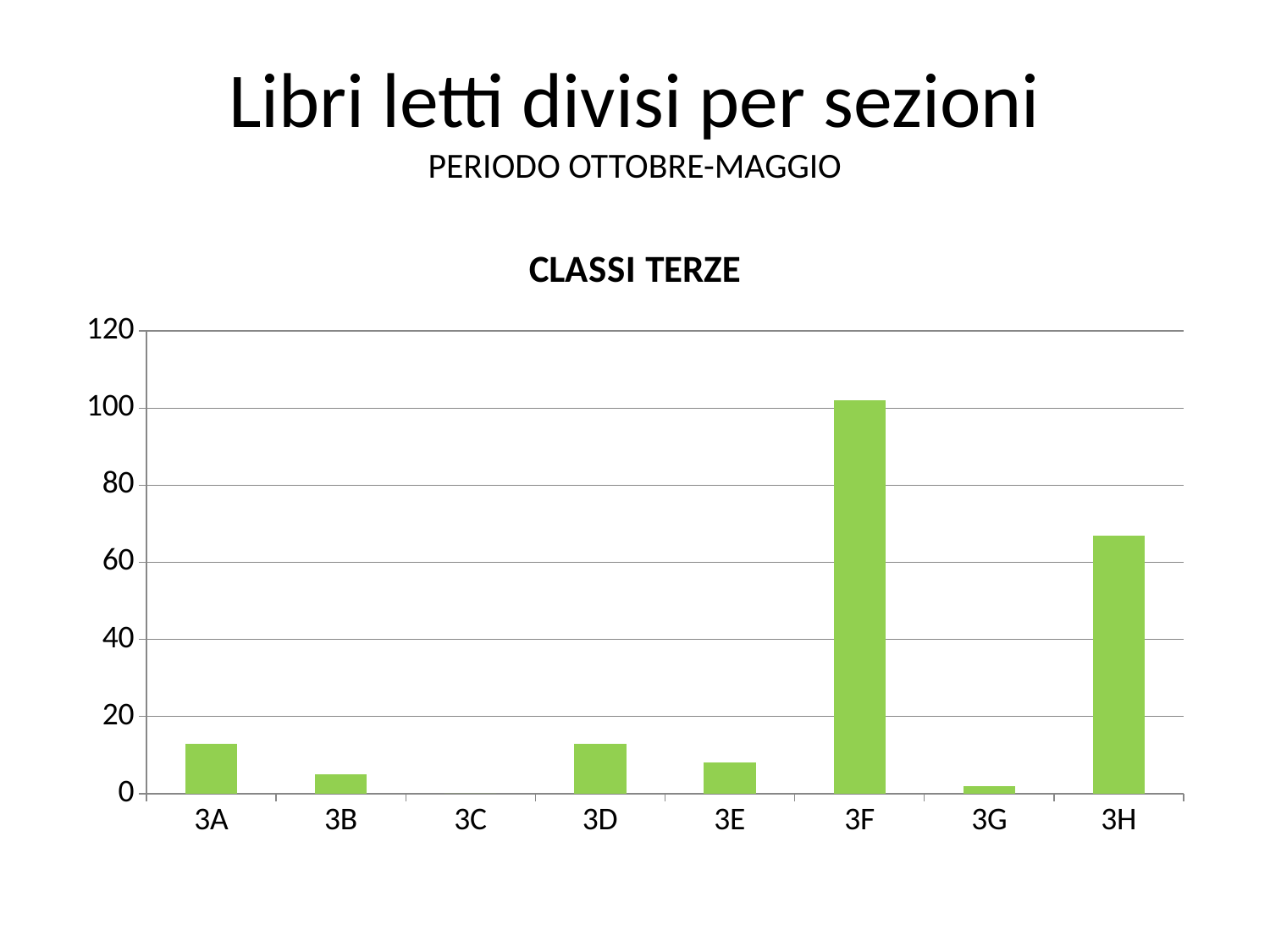
Which class has the lowest number of books read? 3C How many classes (categories) are shown on the x axis of the chart? 8 What kind of chart is shown on the slide? bar chart Which is larger, the value for 3A or the value for 3B? 3A Is the value for 3H greater or less than 80? less Is the value for 3F greater or less than 100? greater Is the value for 3H greater or less than 60? greater What is the value shown for class 3C? 0 What is the title of the chart? CLASSI TERZE Which class has the highest number of books read? 3F Which is larger, the value for 3F or the value for 3H? 3F